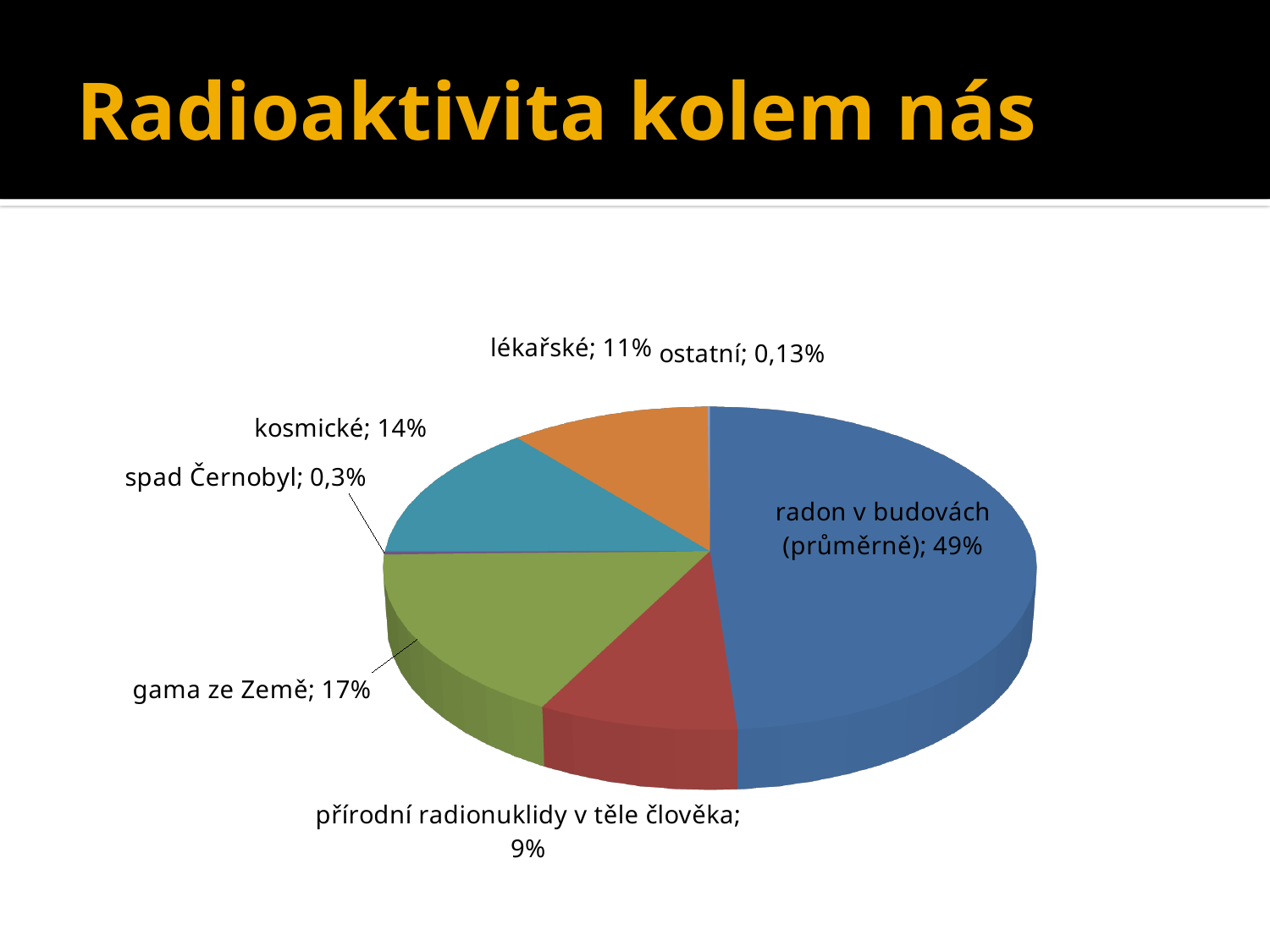
What value is shown for "ostatní"? 0,13% What value is shown for "kosmické"? 14% What kind of chart is shown on the slide? pie chart What is the difference between the share for "radon v budovách (průměrně)" and the share for "přírodní radionuklidy v těle člověka"? 40% Which category has the smallest slice of the pie? ostatní How many slices does the pie chart have? 7 What value is shown for "gama ze Země"? 17% What share of the pie is labelled for "radon v budovách (průměrně)"? 49% Which category has the largest slice of the pie? radon v budovách (průměrně) What value is shown for "spad Černobyl"? 0,3% Which is larger, the share for "gama ze Země" or the share for "kosmické"? gama ze Země What value is shown for "lékařské"? 11%